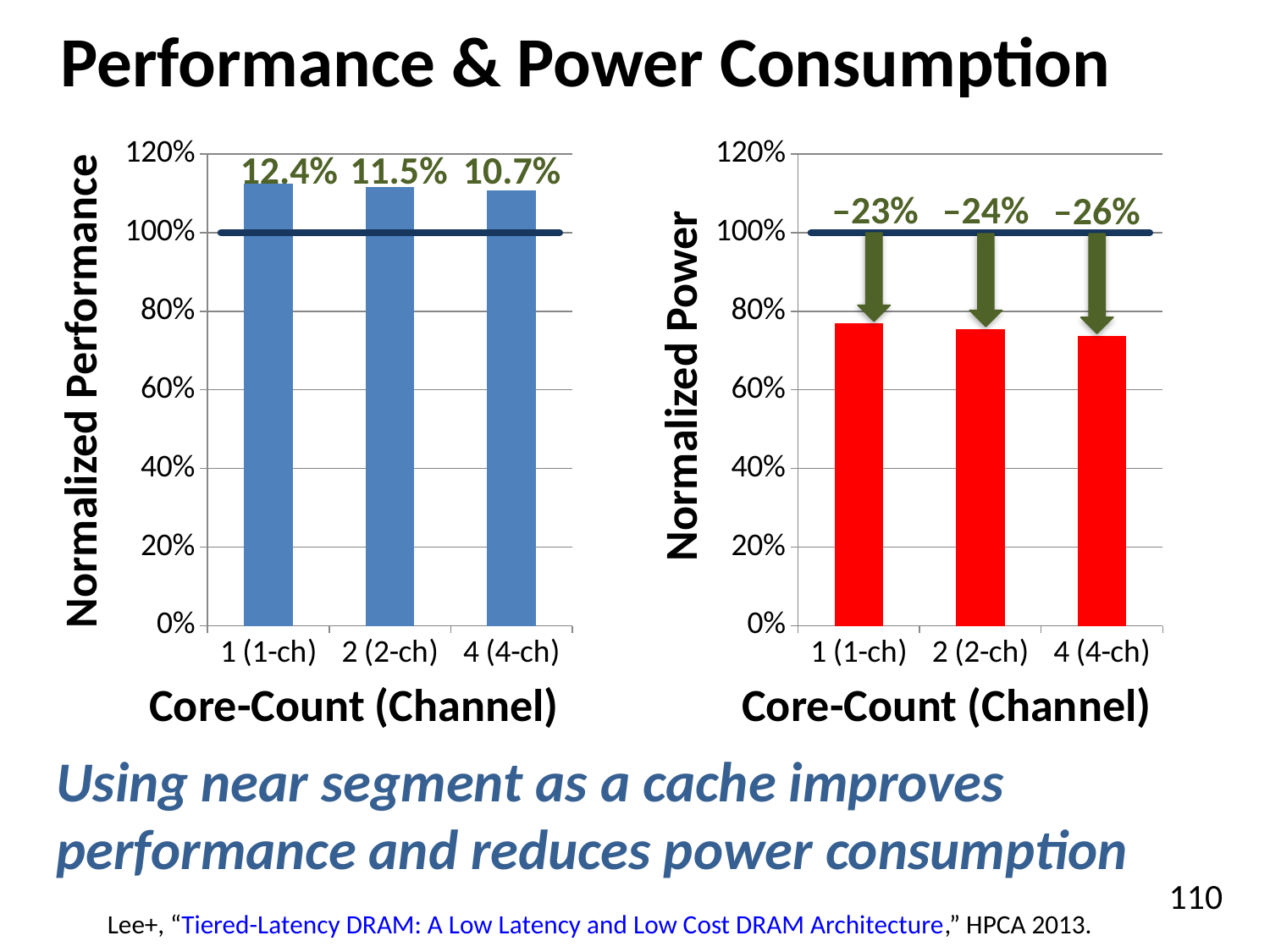
On the Normalized Performance chart, which core-count category has the highest bar? 1 (1-ch) On the Normalized Performance chart, is the value for 2 (2-ch) greater or less than 100%? greater On the Normalized Power chart, do the bar values rise or fall as the core count increases from 1 (1-ch) to 4 (4-ch)? fall On the Normalized Power chart, what percentage label is printed above the bar for 4 (4-ch)? –26% On the Normalized Performance chart, what percentage label is printed above the bar for 1 (1-ch)? 12.4% What colour are the bars on the Normalized Power chart? red On the Normalized Power chart, is the value for 1 (1-ch) greater or less than 80%? less On the Normalized Power chart, what percentage label is printed above the bar for 2 (2-ch)? –24% On the Normalized Performance chart, what percentage label is printed above the bar for 4 (4-ch)? 10.7% What kind of chart is the Normalized Performance chart? bar chart On the Normalized Power chart, which core-count category has the lowest bar? 4 (4-ch) How many core-count categories are shown on the Normalized Power chart? 3